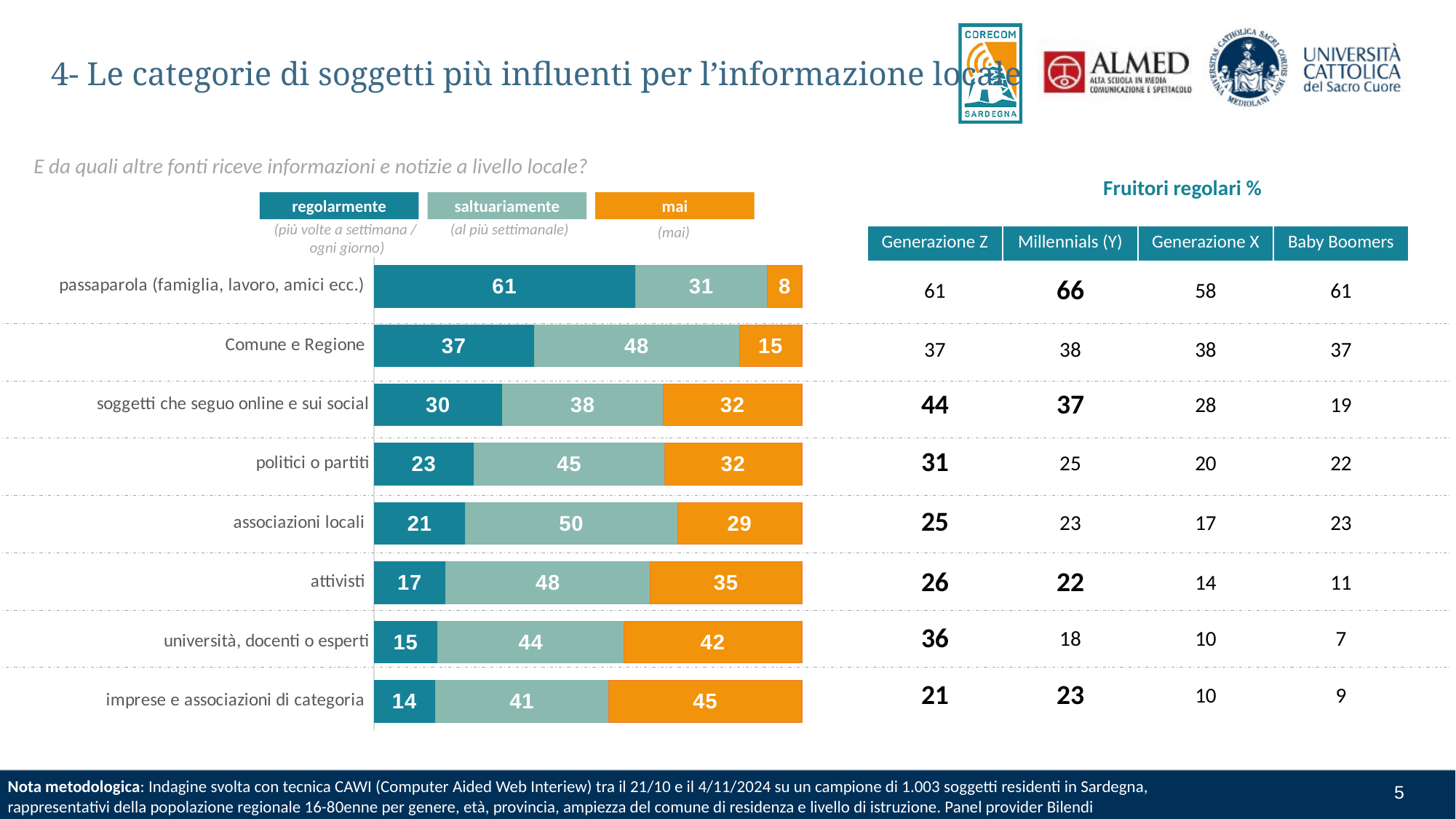
What is the 'saltuariamente' value for 'associazioni locali'? 50 What is the 'mai' value for 'università, docenti o esperti'? 42 Which category has the lowest 'mai' value? passaparola (famiglia, lavoro, amici ecc.) How many series does the chart legend list? 3 What is the difference between the 'mai' values for 'imprese e associazioni di categoria' and 'attivisti'? 10 Which is larger: the 'regolarmente' value for 'Comune e Regione' or for 'soggetti che seguo online e sui social'? Comune e Regione Which category has the highest 'regolarmente' value? passaparola (famiglia, lavoro, amici ecc.) What is the total of the stacked bar for 'politici o partiti'? 100 What kind of chart is shown on the slide? stacked bar chart How many categories (sources) are plotted in the bar chart? 8 Which colour represents the 'mai' series in the chart? orange What is the 'regolarmente' value for 'passaparola (famiglia, lavoro, amici ecc.)'? 61